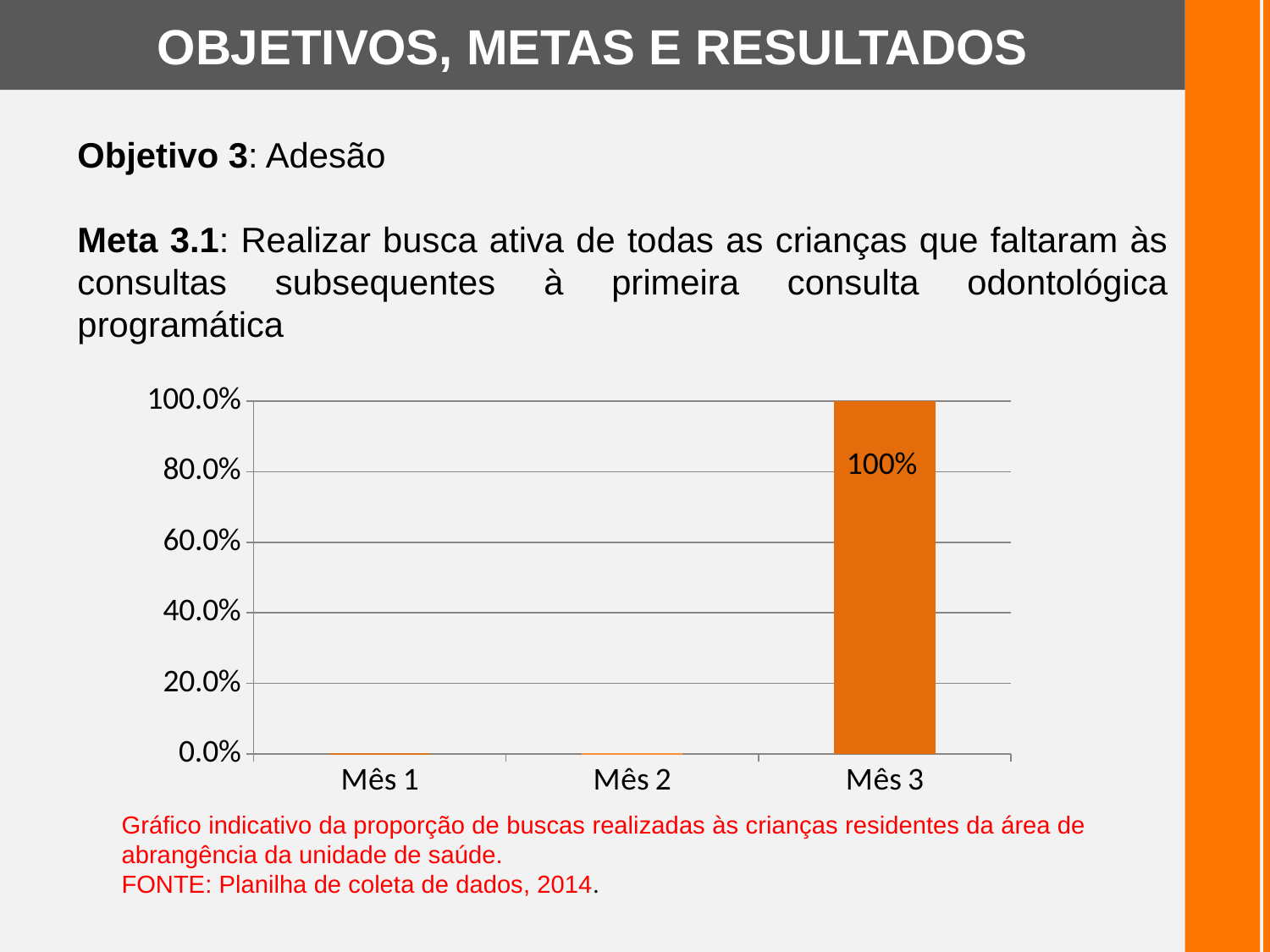
What value is shown for Mês 3? 100% What kind of chart is shown on the slide? bar chart Is the value for Mês 2 greater or less than 20.0%? less Is the value for Mês 1 greater or less than 20.0%? less Which is larger, the value for Mês 1 or the value for Mês 3? Mês 3 What is the highest value shown on the y axis? 100.0% Which month has the highest value? Mês 3 How many months are shown on the x axis? 3 Do the values rise or fall from Mês 1 to Mês 3? rise What colour is the bar for Mês 3? orange Is the value for Mês 3 greater or less than 80.0%? greater